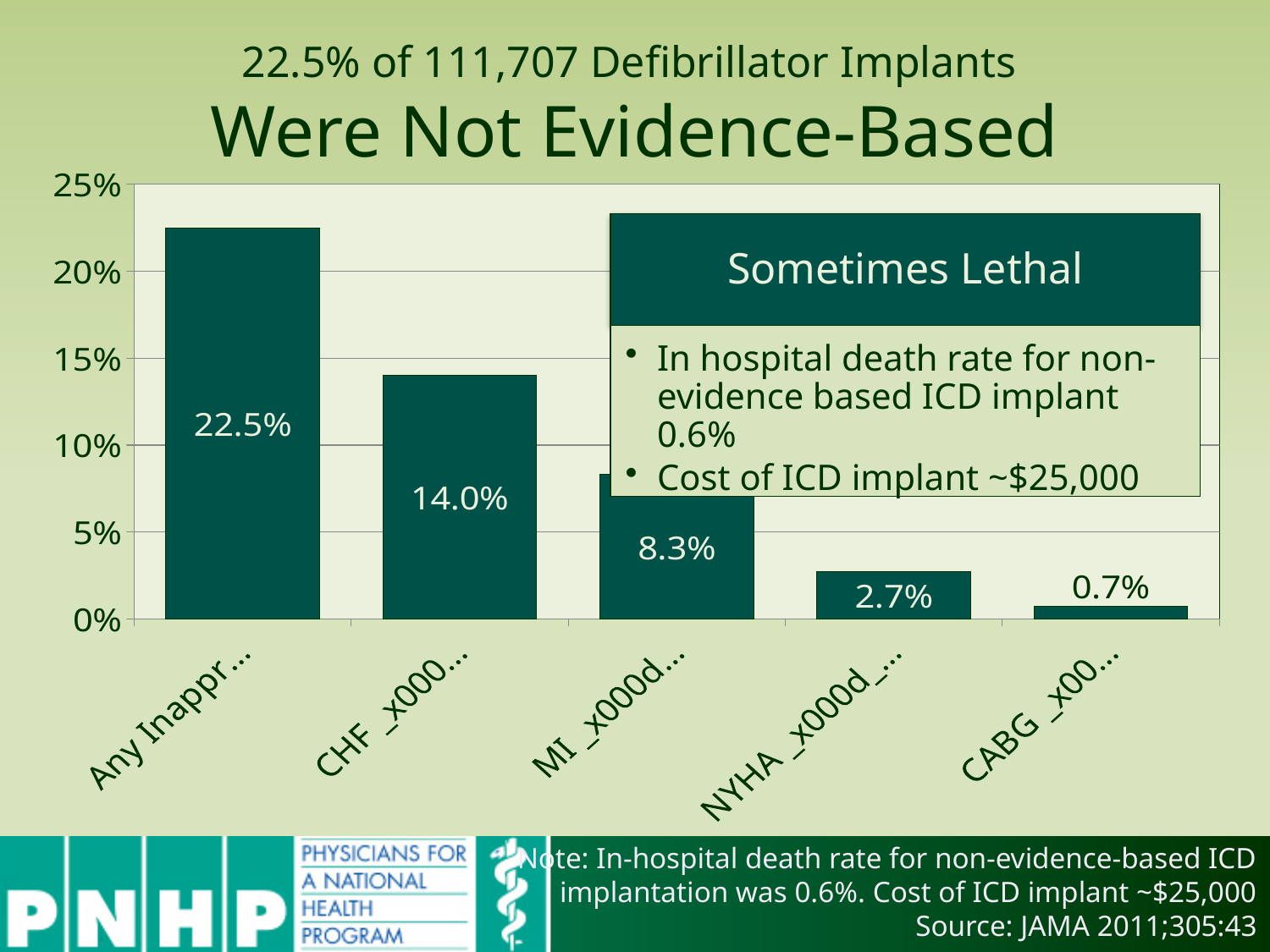
What is the value of the bar labelled "NYHA…"? 2.7% Which bar has the highest value? Any Inappr… What kind of chart is shown on the slide? bar chart Which is larger, the value for "NYHA…" or the value for "CABG…"? NYHA… Do the bar values rise or fall from left to right along the x axis? fall What is the difference between the "CHF…" bar and the "MI…" bar? 5.7% What is the value of the bar labelled "MI…"? 8.3% What is the value of the bar labelled "CABG…"? 0.7% What is the value of the bar labelled "CHF…"? 14.0% How many bars are plotted in the chart? 5 What is the value of the bar labelled "Any Inappr…"? 22.5% Which bar has the lowest value? CABG…